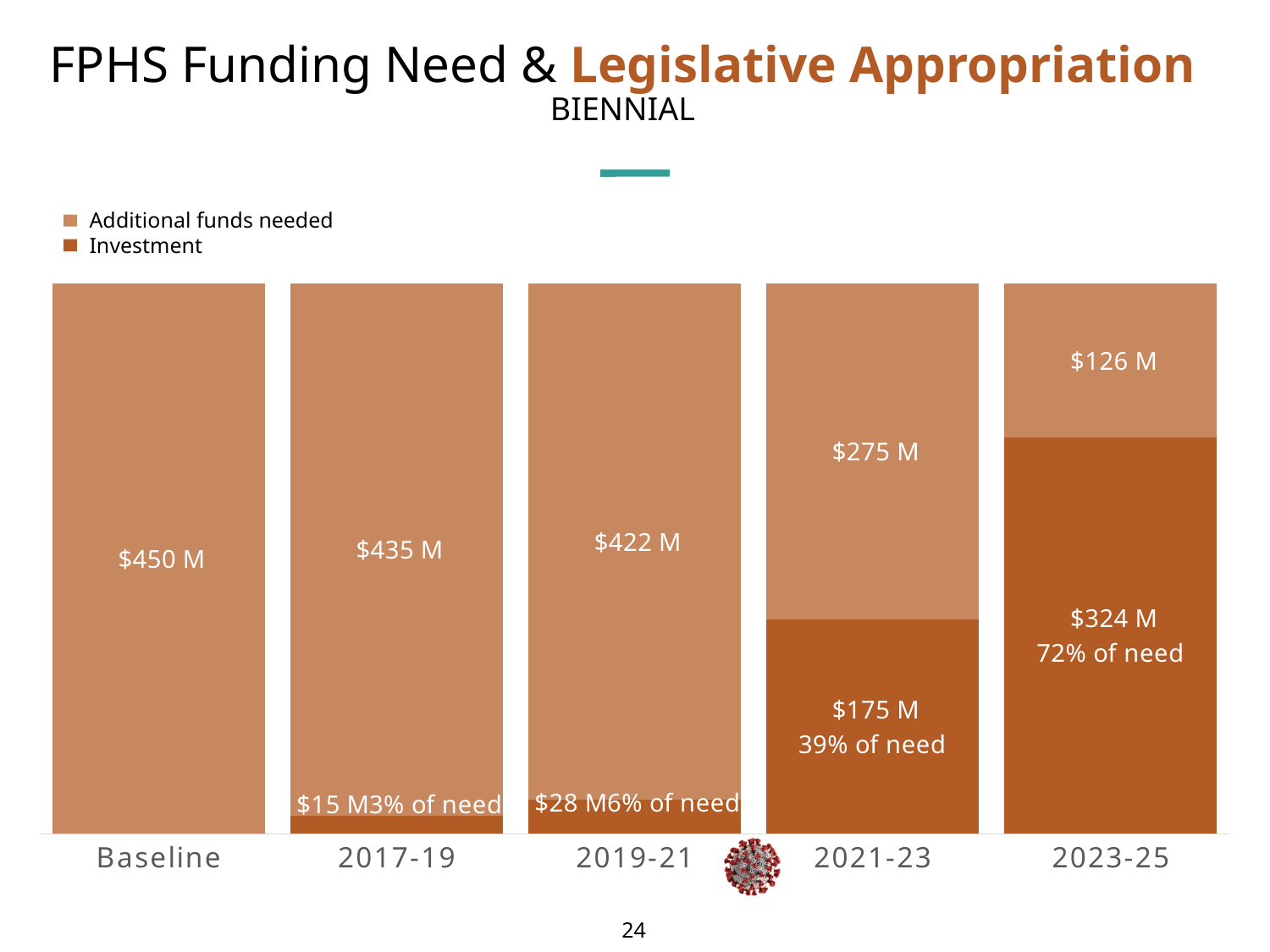
How many series does the legend list? 2 Does the Investment value rise or fall from 2017-19 to 2023-25? Rise What percentage of need does the Investment for 2021-23 represent? 39% of need What is the Additional funds needed value for 2019-21? $422 M Which is larger, the Investment for 2019-21 or the Investment for 2017-19? Investment for 2019-21 What type of chart is shown on the slide? Stacked bar chart What is the Investment value for 2023-25? $324 M Which category has the lowest Additional funds needed value? 2023-25 What is the difference between the Investment values for 2023-25 and 2021-23? $149 M What is the total of the stacked bar for 2021-23? $450 M How many categories are shown along the x axis? 5 Which biennium has the highest Investment value? 2023-25